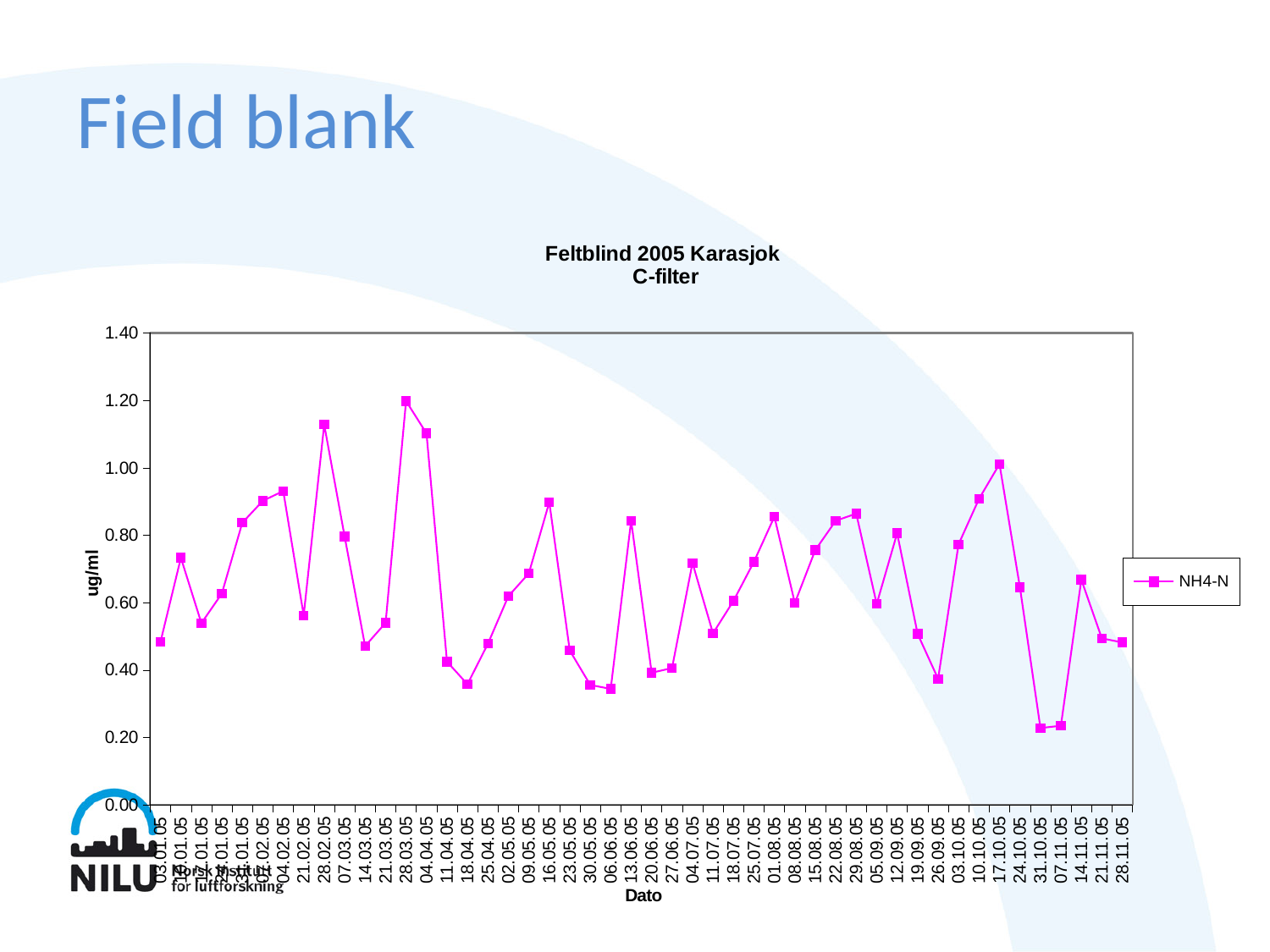
Is the value for 28.02.05 greater or less than 1.00? greater Which date has the larger NH4-N value, 28.03.05 or 31.10.05? 28.03.05 What kind of chart is shown on the slide? line chart Which date has the larger NH4-N value, 14.03.05 or 28.02.05? 28.02.05 Is the value for 28.03.05 greater or less than 1.00? greater How many series does the legend list? 1 What is the name of the series shown in the legend? NH4-N Is the value for 31.10.05 greater or less than 0.40? less On which date does the NH4-N value reach its highest point? 28.03.05 What is the label on the y axis? ug/ml How many data points are plotted on the chart? 48